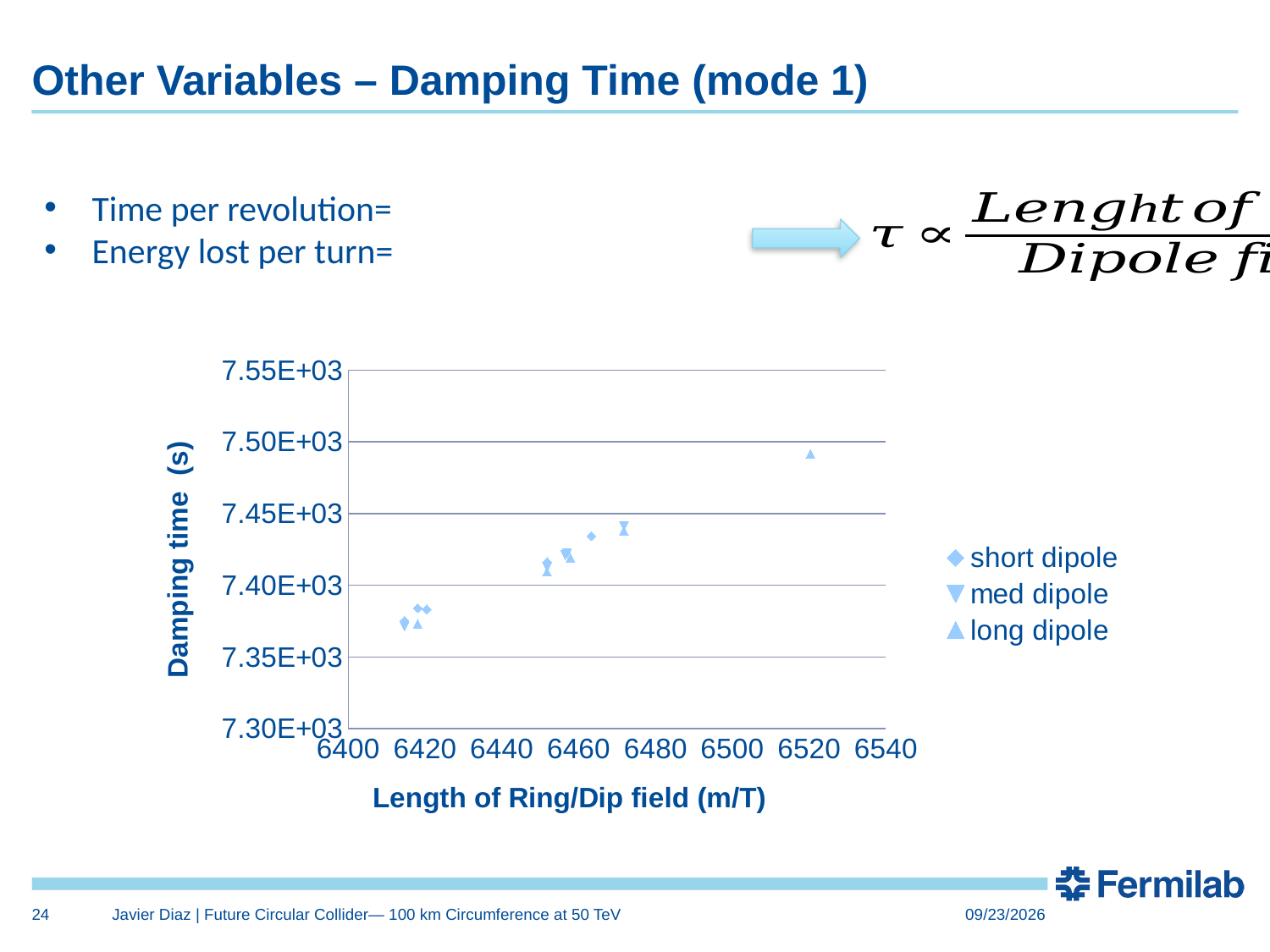
Is the damping time of the long dipole point near 6520 m/T greater or less than 7.45E+03? greater Are the damping time values of the points near 6420 m/T greater or less than 7.40E+03? less How many series does the legend list? 3 What is the highest value shown on the y axis? 7.55E+03 Is the damping time of the point near 6520 m/T larger or smaller than the damping time of the points near 6420 m/T? larger What is the title of the y axis? Damping time (s) Which series contains the point with the highest damping time? long dipole What kind of chart is shown on the slide? scatter chart Are the damping time values of the points near 6460 m/T greater or less than 7.40E+03? greater What are the three series named in the legend? short dipole, med dipole, long dipole Do the damping time values rise or fall as Length of Ring/Dip field increases along the x axis? rise